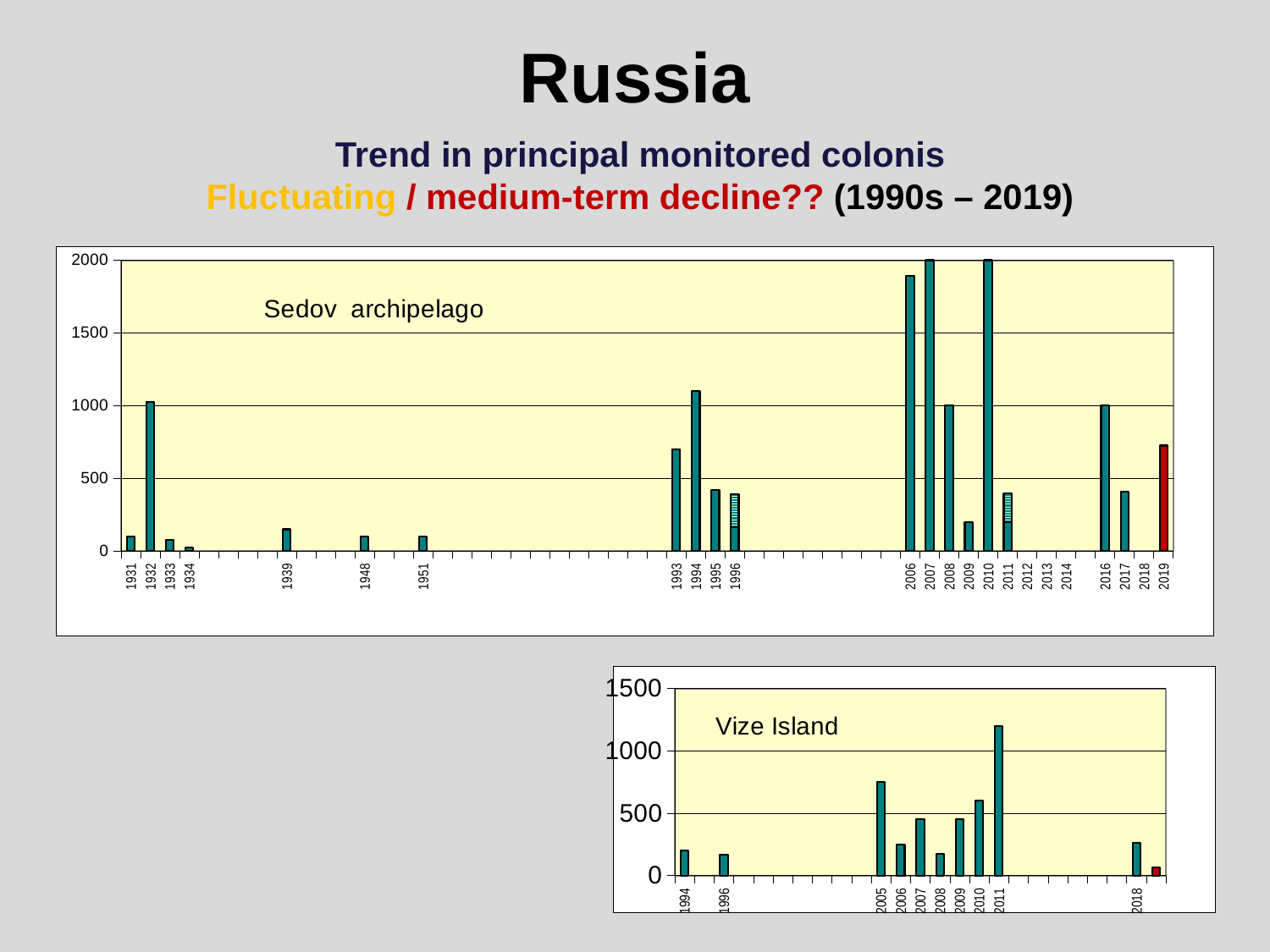
In the Sedov archipelago chart, is the value for 2019 greater or less than 500? greater In the Vize Island chart, is the value for 2006 greater or less than 500? less In the Sedov archipelago chart, which is larger, the value for 1931 or the value for 1932? 1932 In the Sedov archipelago chart, what colour is the bar for 2019? red In the Sedov archipelago chart, which year has the lowest value? 1934 In the Vize Island chart, which is larger, the value for 2005 or the value for 2007? 2005 In the Vize Island chart, which year has the highest value? 2011 In the Sedov archipelago chart, is the value for 1994 greater or less than 1000? greater What kind of chart is the Sedov archipelago chart? bar chart